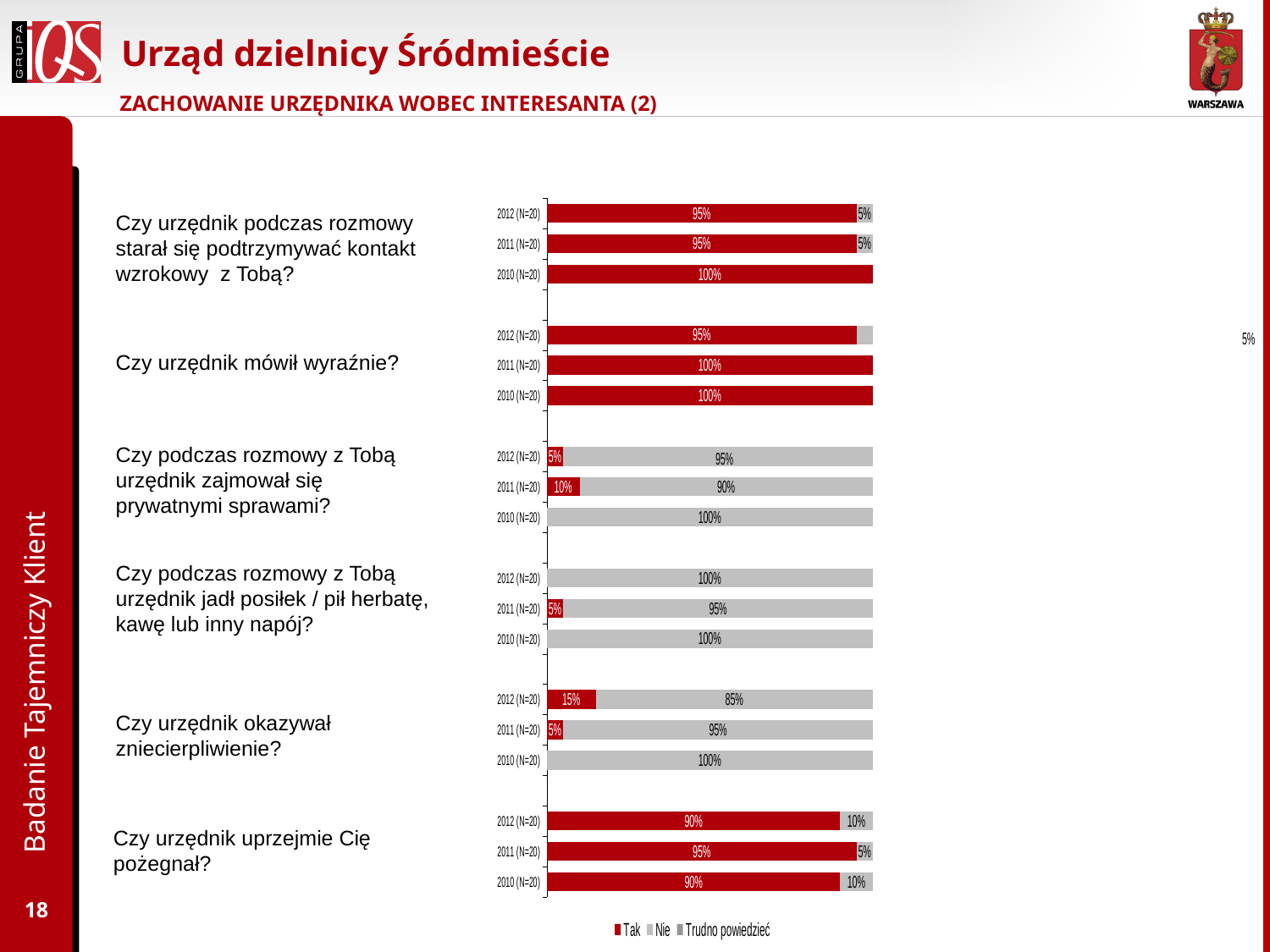
How many years (bars) are shown for each question in the chart? 3 What percentage answered "Nie" in 2012 (N=20) for "Czy urzędnik okazywał zniecierpliwienie?"? 85% What percentage answered "Tak" in 2012 (N=20) for "Czy urzędnik okazywał zniecierpliwienie?"? 15% How many series does the chart legend list? 3 What percentage answered "Nie" in 2010 (N=20) for "Czy urzędnik uprzejmie Cię pożegnał?"? 10% What percentage answered "Nie" in 2012 (N=20) for "Czy podczas rozmowy z Tobą urzędnik jadł posiłek / pił herbatę, kawę lub inny napój?"? 100% For "Czy urzędnik uprzejmie Cię pożegnał?", what is the difference in the "Tak" share between 2011 (N=20) and 2012 (N=20)? 5 percentage points What are the legend entries of the chart? Tak, Nie, Trudno powiedzieć What kind of chart is shown on the slide? Stacked bar chart For "Czy urzędnik okazywał zniecierpliwienie?", which year has the larger "Tak" share, 2012 or 2011? 2012 What percentage answered "Tak" in 2012 (N=20) for "Czy urzędnik uprzejmie Cię pożegnał?"? 90% What percentage answered "Tak" in 2011 (N=20) for "Czy podczas rozmowy z Tobą urzędnik zajmował się prywatnymi sprawami?"? 10%